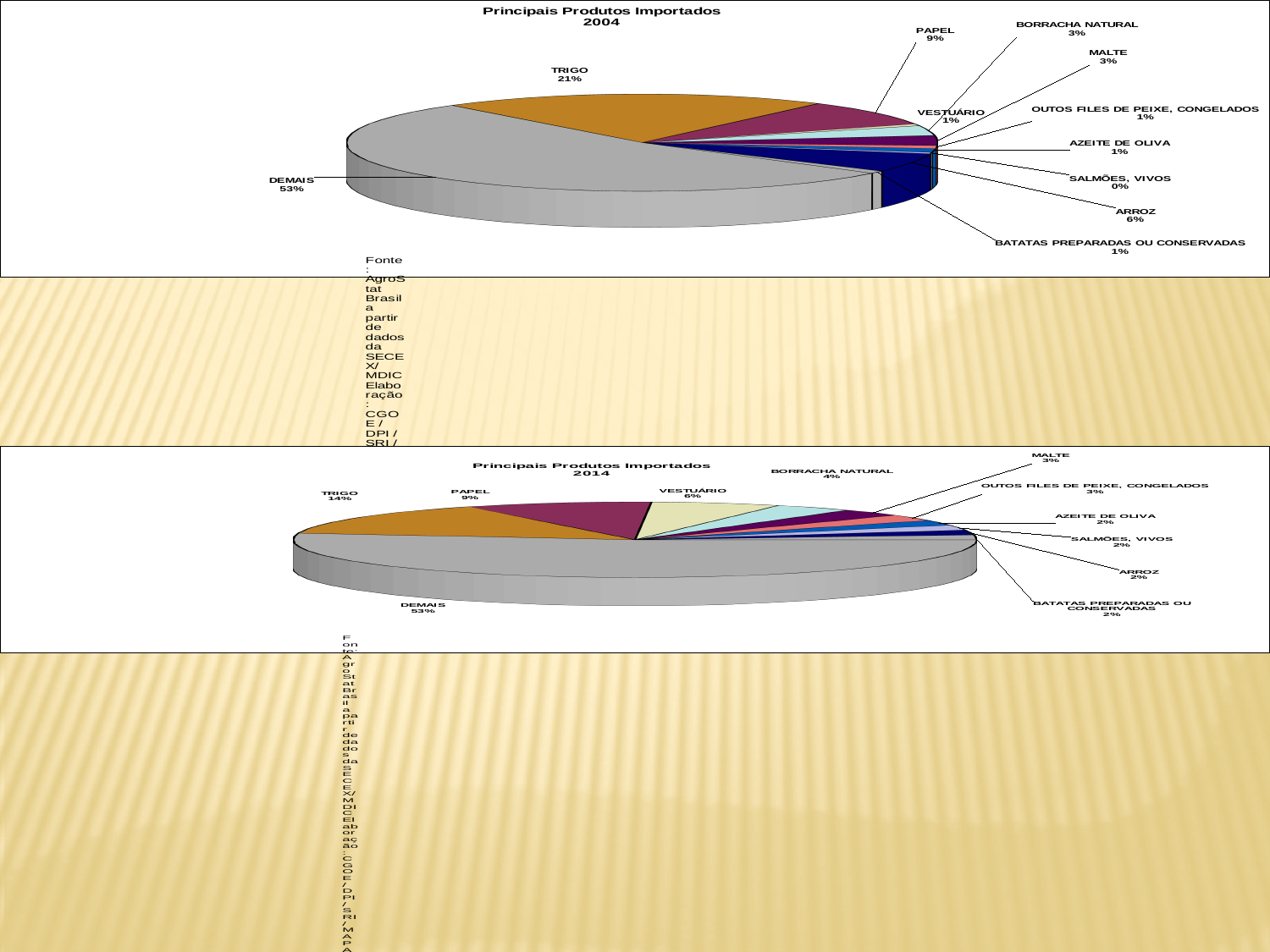
In the 2004 chart, which product has the smallest share? SALMÕES, VIVOS In the 2014 chart, what is the difference between the shares of DEMAIS and TRIGO? 39% In the 2004 chart (Principais Produtos Importados 2004), what share does TRIGO have? 21% In the 2004 chart, what is the difference between the shares of TRIGO and PAPEL? 12% In the 2014 chart, which is larger, the share of PAPEL or the share of BORRACHA NATURAL? PAPEL What type of chart is the 2004 chart? Pie chart In the 2004 chart, what share does ARROZ have? 6% In the 2004 chart, which slice is the largest? DEMAIS In the 2014 chart, what share does VESTUÁRIO have? 6% In the 2014 chart (Principais Produtos Importados 2014), what share does TRIGO have? 14% What is the title of the bottom chart on the slide? Principais Produtos Importados 2014 How many slices does the 2014 chart have? 11